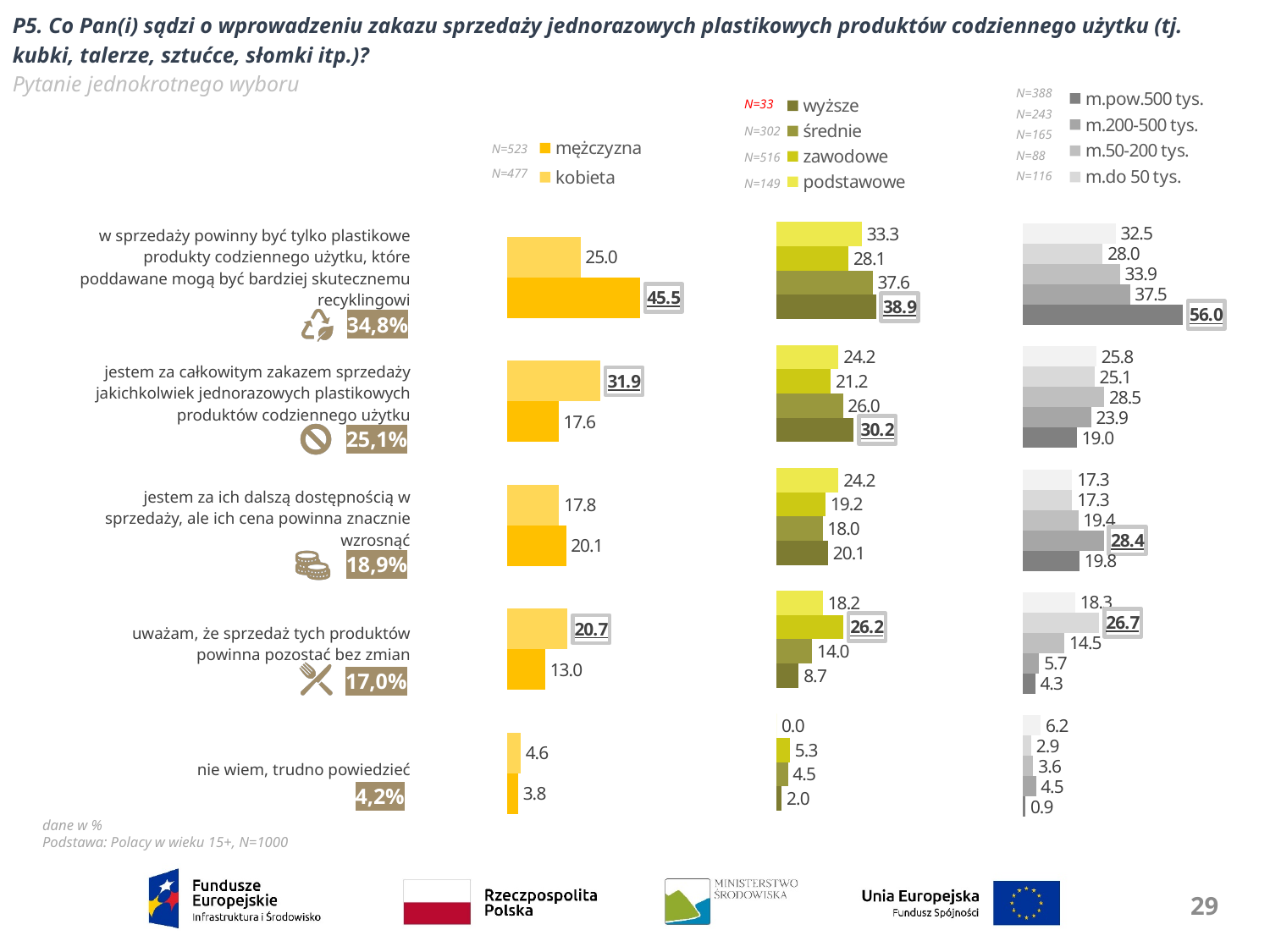
In the education chart (wyższe/średnie/zawodowe/podstawowe), what is the value for wyższe for the response 'jestem za całkowitym zakazem sprzedaży jakichkolwiek jednorazowych plastikowych produktów codziennego użytku'? 30.2 In the gender chart, what is the difference between the kobieta and mężczyzna values for 'uważam, że sprzedaż tych produktów powinna pozostać bez zmian'? 7.7 In the gender chart, which is larger for 'jestem za ich dalszą dostępnością w sprzedaży, ale ich cena powinna znacznie wzrosnąć': mężczyzna or kobieta? mężczyzna In the city-size chart, what is the lowest value shown for 'nie wiem, trudno powiedzieć'? 0.9 In the gender chart (mężczyzna/kobieta), what is the value for mężczyzna for the response 'w sprzedaży powinny być tylko plastikowe produkty codziennego użytku, które poddawane mogą być bardziej skutecznemu recyklingowi'? 45.5 How many response categories are shown on the slide? 5 In the education chart, what is the value for podstawowe for 'nie wiem, trudno powiedzieć'? 0.0 In the education chart, which education group has the highest value for 'uważam, że sprzedaż tych produktów powinna pozostać bez zmian'? zawodowe What kind of chart is used to show the results by gender? bar chart In the city-size chart (m.pow.500 tys. etc.), what is the highest value shown for the response 'w sprzedaży powinny być tylko plastikowe produkty codziennego użytku, które poddawane mogą być bardziej skutecznemu recyklingowi'? 56.0 How many series does the legend of the education chart list? 4 In the gender chart, what is the value for kobieta for the response 'jestem za całkowitym zakazem sprzedaży jakichkolwiek jednorazowych plastikowych produktów codziennego użytku'? 31.9